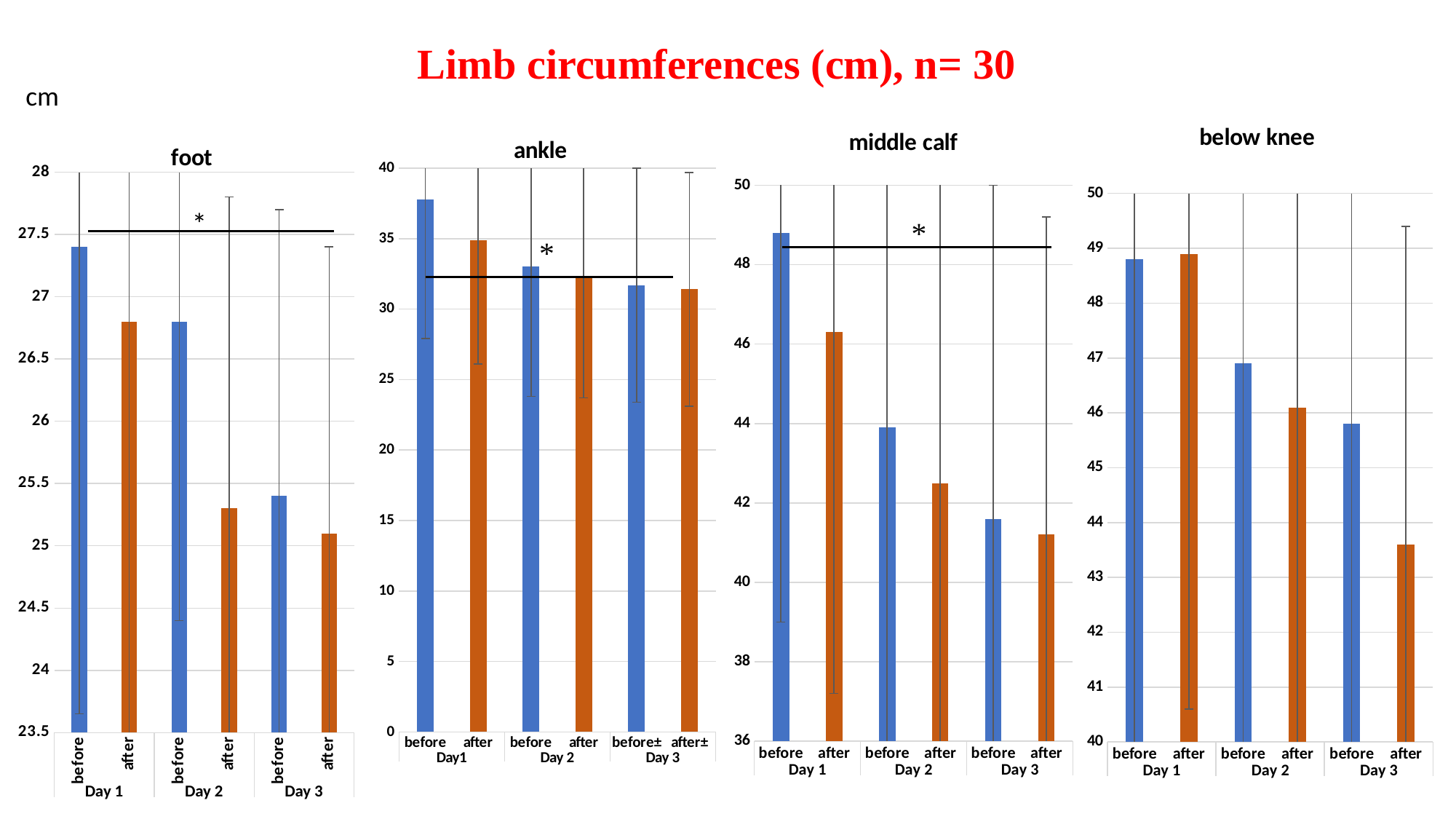
How many bars are plotted in the 'middle calf' chart? 6 In the 'below knee' chart, is the value for Day 3 after greater or less than 44? less In the 'ankle' chart, which bar is the highest? Day1 before In the 'foot' chart, is the value for Day 3 after greater or less than 25.5? less In the 'foot' chart, is the value for Day 1 before greater or less than 27? greater In the 'foot' chart, do the 'before' values rise or fall from Day 1 to Day 3? fall In the 'foot' chart, which bar is the highest? Day 1 before In the 'middle calf' chart, which is larger: Day 1 after or Day 2 before? Day 1 after What kind of chart is the 'foot' chart? bar chart In the 'below knee' chart, which bar is the lowest? Day 3 after